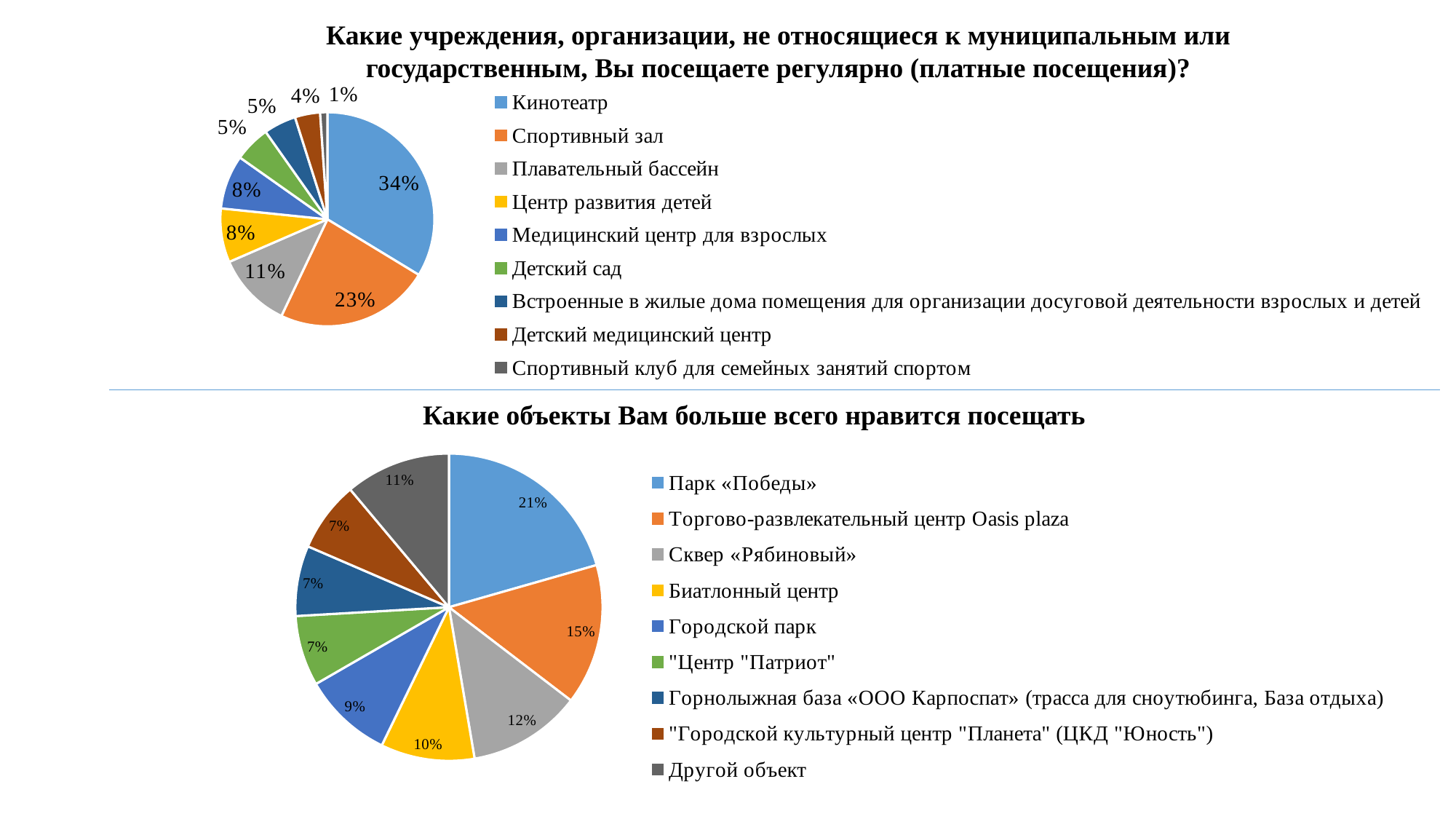
In the bottom chart, which is larger: Сквер «Рябиновый» or Городской парк? Сквер «Рябиновый» In the top chart, which category has the largest share? Кинотеатр In the top chart, how many categories does the legend list? 9 What type of chart is the bottom chart (Какие объекты Вам больше всего нравится посещать)? Pie chart In the top chart (paid visits to non-municipal organisations), what share does Кинотеатр have? 34% In the bottom chart, what colour is the slice for Другой объект? Dark grey In the bottom chart, what share does Парк «Победы» have? 21% In the bottom chart, what share does Биатлонный центр have? 10% In the top chart, what is the difference between the shares of Кинотеатр and Спортивный зал? 11% In the top chart, what share does Плавательный бассейн have? 11% In the bottom chart, what is the difference between the shares of Парк «Победы» and Торгово-развлекательный центр Oasis plaza? 6% In the top chart, which category has the smallest share? Спортивный клуб для семейных занятий спортом